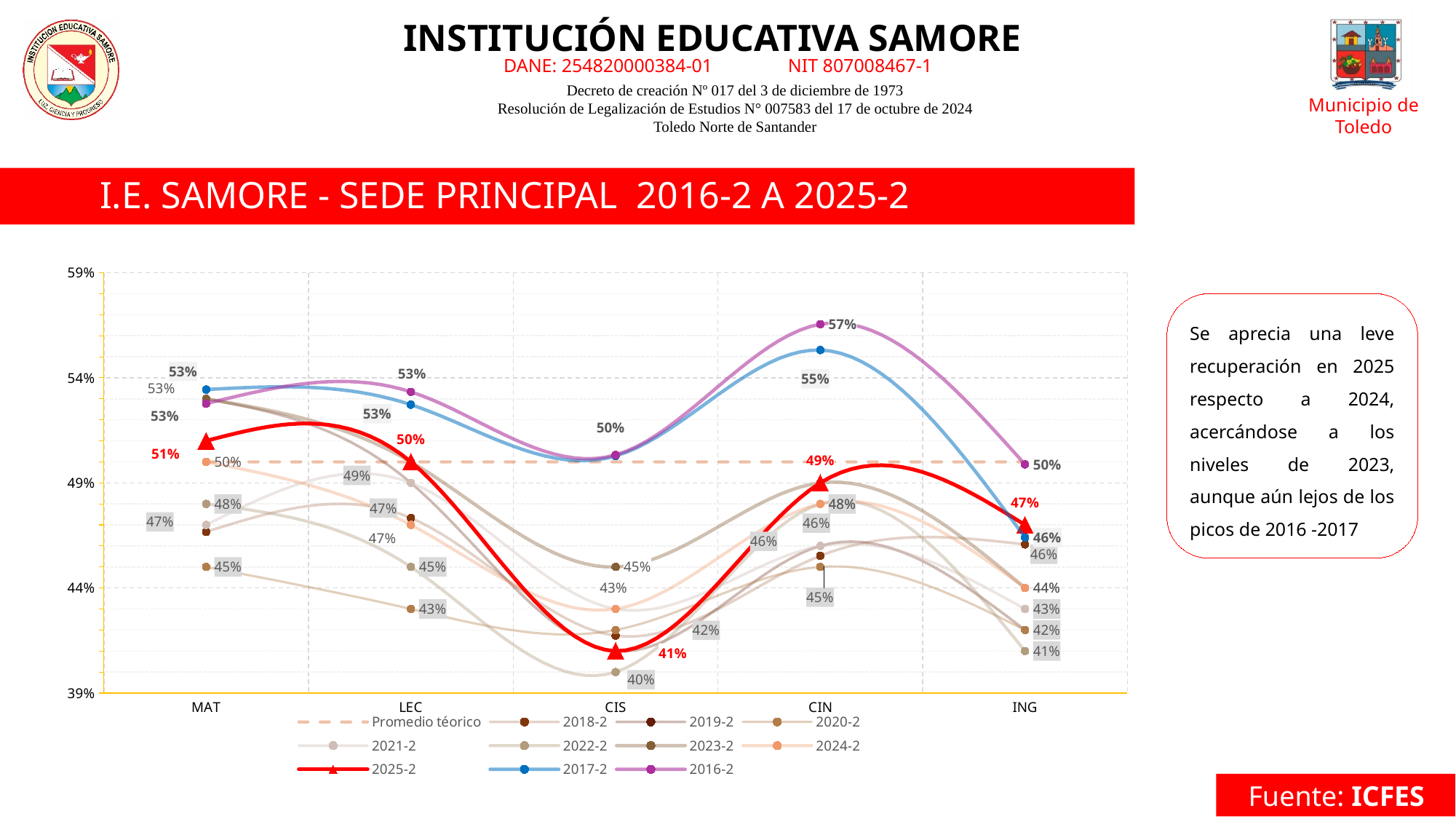
For the 2025-2 series, which category has the lowest value? CIS What is the value of the 2025-2 series for MAT? 51% How many series does the chart legend list? 11 Is the value of the 2017-2 series for CIN greater or less than 54%? greater What is the value of the 2025-2 series for CIS? 41% Which series is drawn with triangle markers in the chart? 2025-2 What is the value of the 2025-2 series for CIN? 49% What is the difference between the 2025-2 values for MAT and CIS? 10 percentage points What is the value of the 2016-2 series for CIN? 57% For the 2025-2 series, which category has the highest value? MAT How many categories are shown on the x axis of the chart? 5 What kind of chart is shown on the slide? line chart